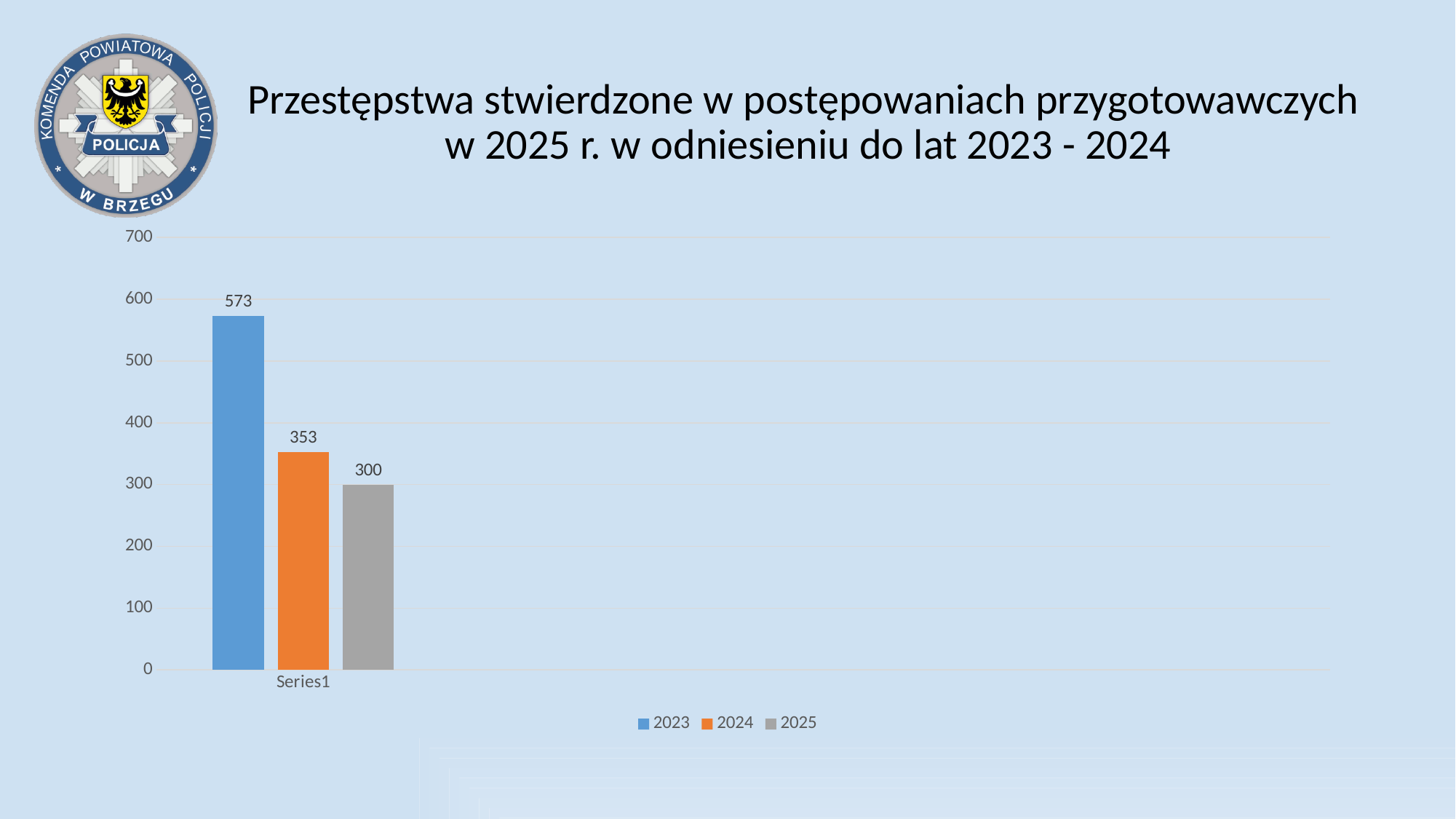
What is the difference between the values for 2023 and 2024? 220 What is the value for 2023? 573 What is the value for 2025? 300 How many series does the legend list? 3 What kind of chart is shown on the slide? bar chart Do the values rise or fall from 2023 to 2025? fall Which year has the lowest value? 2025 Which is larger, the value for 2024 or the value for 2025? 2024 What is the difference between the values for 2024 and 2025? 53 What is the value for 2024? 353 Is the value for 2023 greater or less than 500? greater Which year has the highest value? 2023